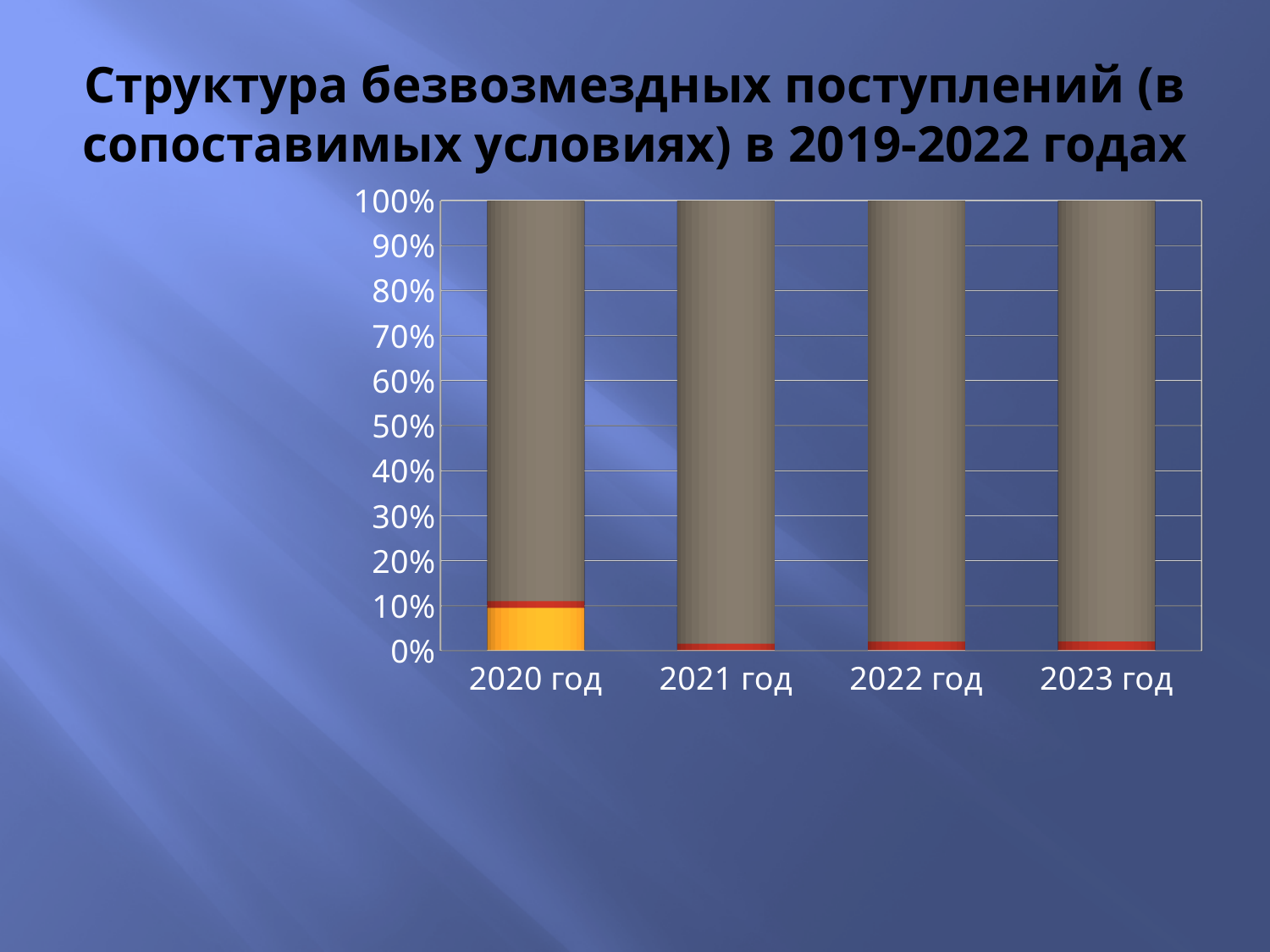
Is the red segment for 2023 год greater or less than 10%? less Which year has the largest grey segment: 2020 год or 2021 год? 2021 год What is the last category on the x axis of the chart? 2023 год What is the first category on the x axis of the chart? 2020 год Is the yellow segment for 2020 год greater or less than 20%? less Is the grey segment for 2020 год greater or less than 50%? greater Which year is the only one with a yellow segment in its bar? 2020 год What kind of chart is shown on the slide? Stacked bar chart How many years (categories) are shown on the x axis of the chart? 4 What is the maximum value shown on the y axis of the chart? 100%